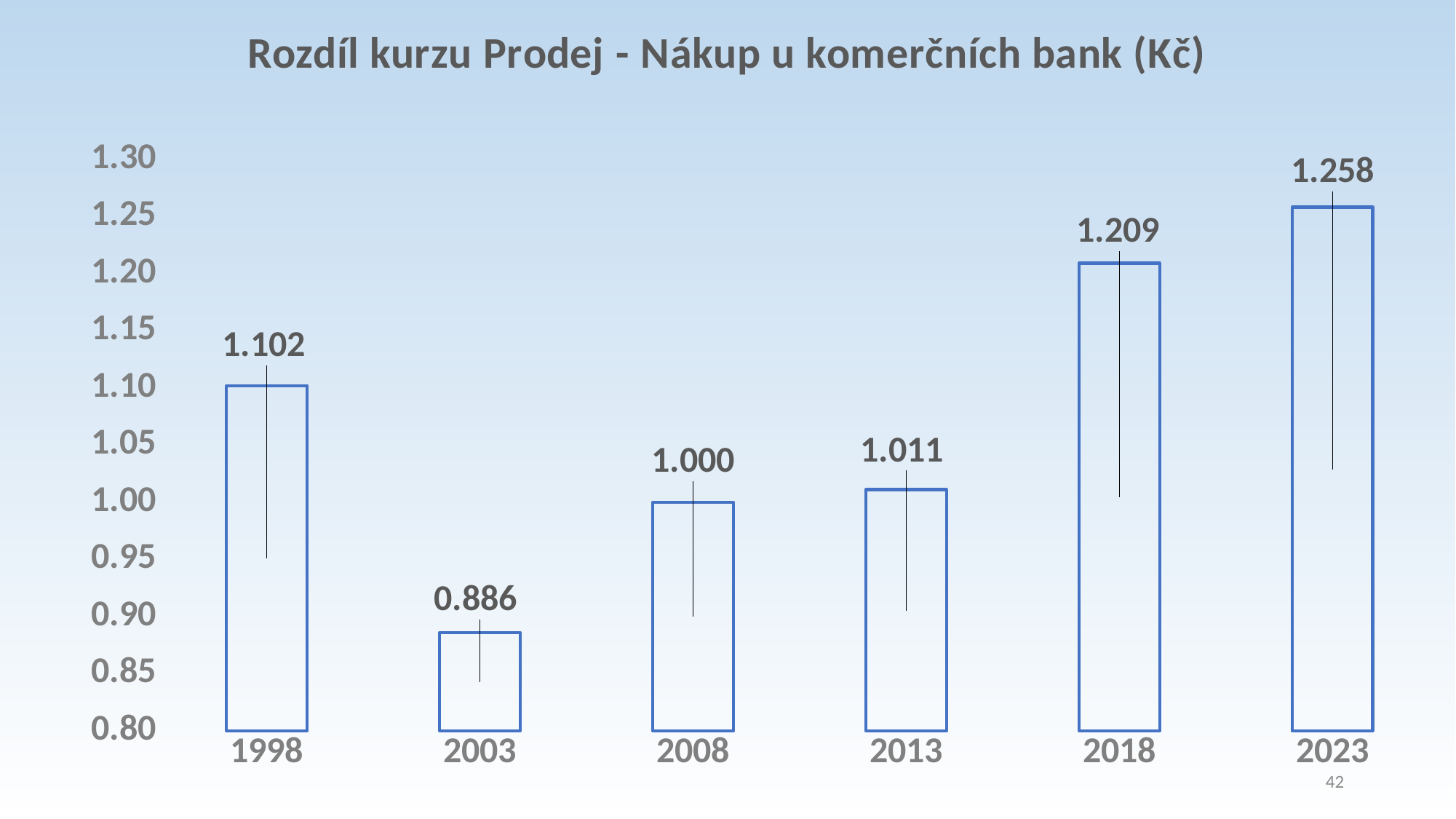
What is the difference between the values for 1998 and 2003? 0.216 Which is larger, the value for 1998 or the value for 2013? 1998 What is the value for 2018? 1.209 What is the value for 2003? 0.886 How many years are shown on the chart? 6 What kind of chart is shown on the slide? bar chart Which year has the lowest value? 2003 Which year has the highest value? 2023 What is the value for 1998? 1.102 What is the difference between the values for 2023 and 2018? 0.049 Is the value for 2008 greater or less than 1.05? less What is the title of the chart? Rozdíl kurzu Prodej - Nákup u komerčních bank (Kč)